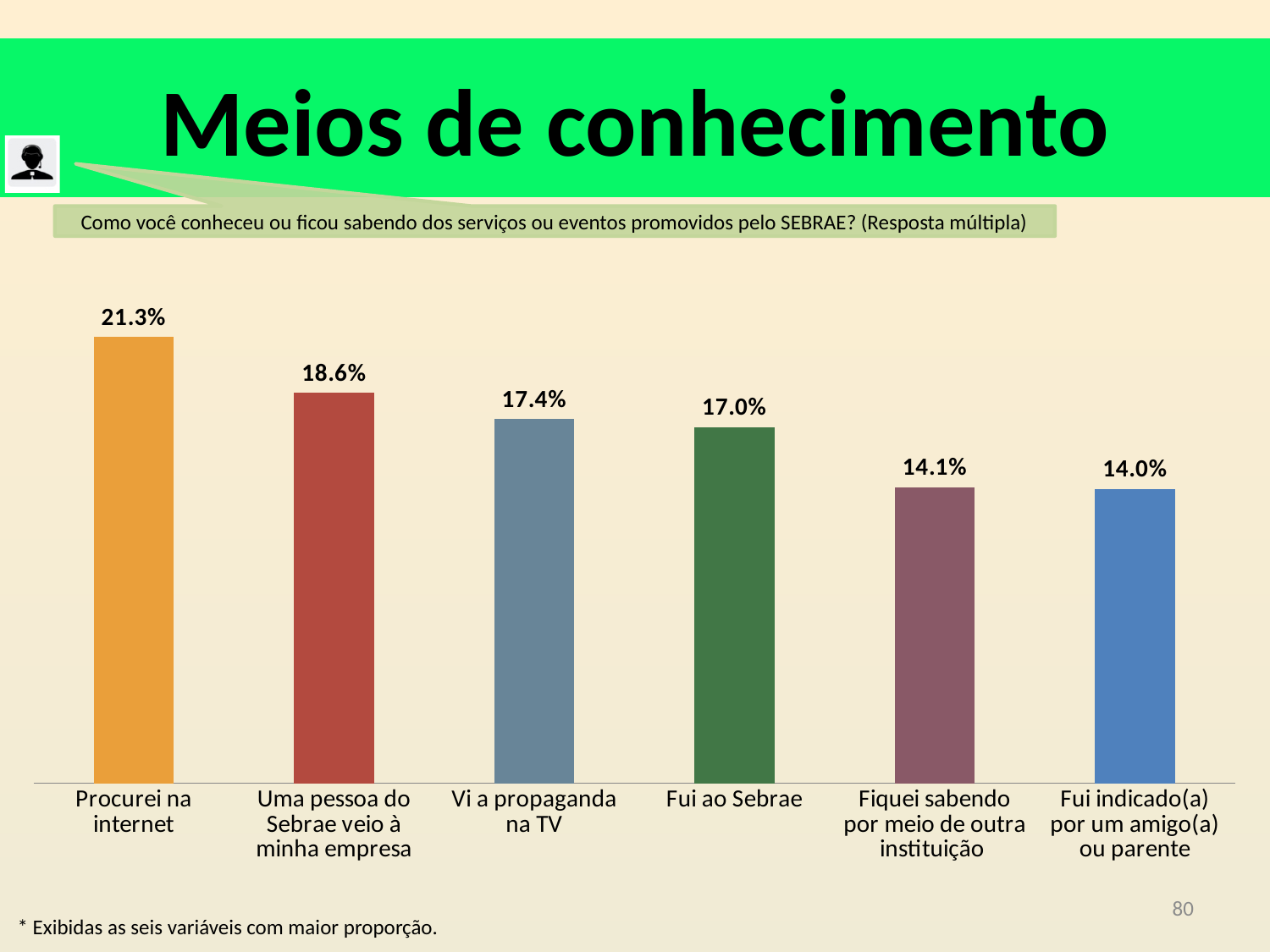
What is the title of the slide? Meios de conhecimento What is the value for "Vi a propaganda na TV"? 17.4% Which is larger: "Uma pessoa do Sebrae veio à minha empresa" or "Fiquei sabendo por meio de outra instituição"? Uma pessoa do Sebrae veio à minha empresa Do the values rise or fall from left to right across the categories? Fall Which category has the highest value? Procurei na internet What is the value for "Fui ao Sebrae"? 17.0% What is the value for "Fui indicado(a) por um amigo(a) ou parente"? 14.0% What is the difference between "Procurei na internet" and "Uma pessoa do Sebrae veio à minha empresa"? 2.7% Which category has the lowest value? Fui indicado(a) por um amigo(a) ou parente What kind of chart is shown on the slide? Bar chart How many categories are shown in the chart? 6 What is the value for "Procurei na internet"? 21.3%